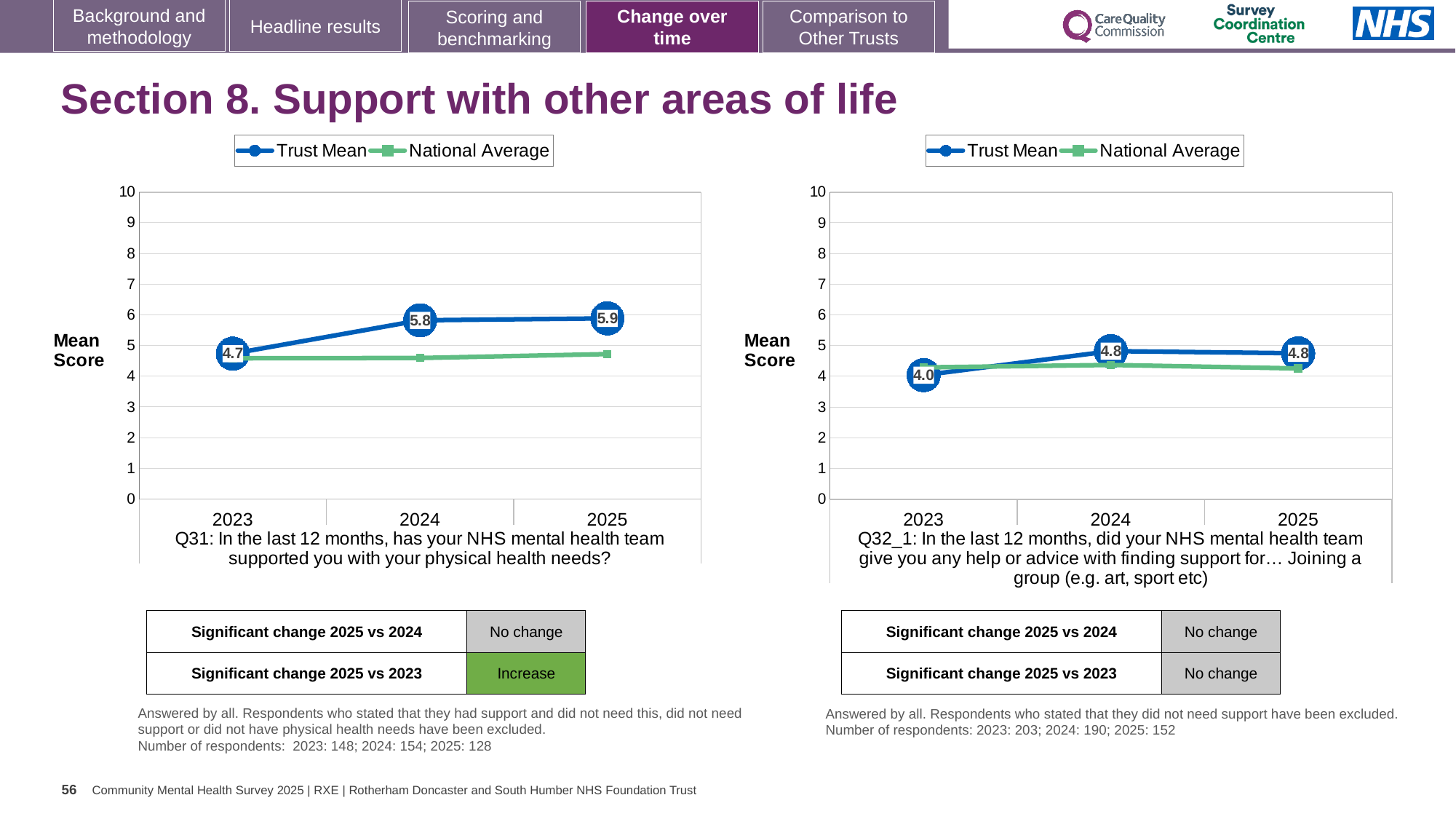
How many series does the legend of the left chart (Q31) list? 2 On the right chart (Q32_1), what is the difference between the Trust Mean in 2024 and in 2023? 0.8 On the right chart (Q32_1), what is the Trust Mean score for 2023? 4.0 On the left chart (Q31), in which year is the Trust Mean highest? 2025 On the left chart (Q31), what is the difference between the Trust Mean in 2025 and in 2023? 1.2 On the right chart (Q32_1), in 2023, which is higher: the Trust Mean or the National Average? National Average What kind of chart is the right chart (Q32_1)? Line chart On the left chart (Q31), what is the Trust Mean score for 2025? 5.9 On the left chart (Q31), is the National Average for 2025 greater or less than 5? less On the left chart (Q31), what is the Trust Mean score for 2023? 4.7 On the right chart (Q32_1), what is the Trust Mean score for 2024? 4.8 On the right chart (Q32_1), in which year is the Trust Mean lowest? 2023